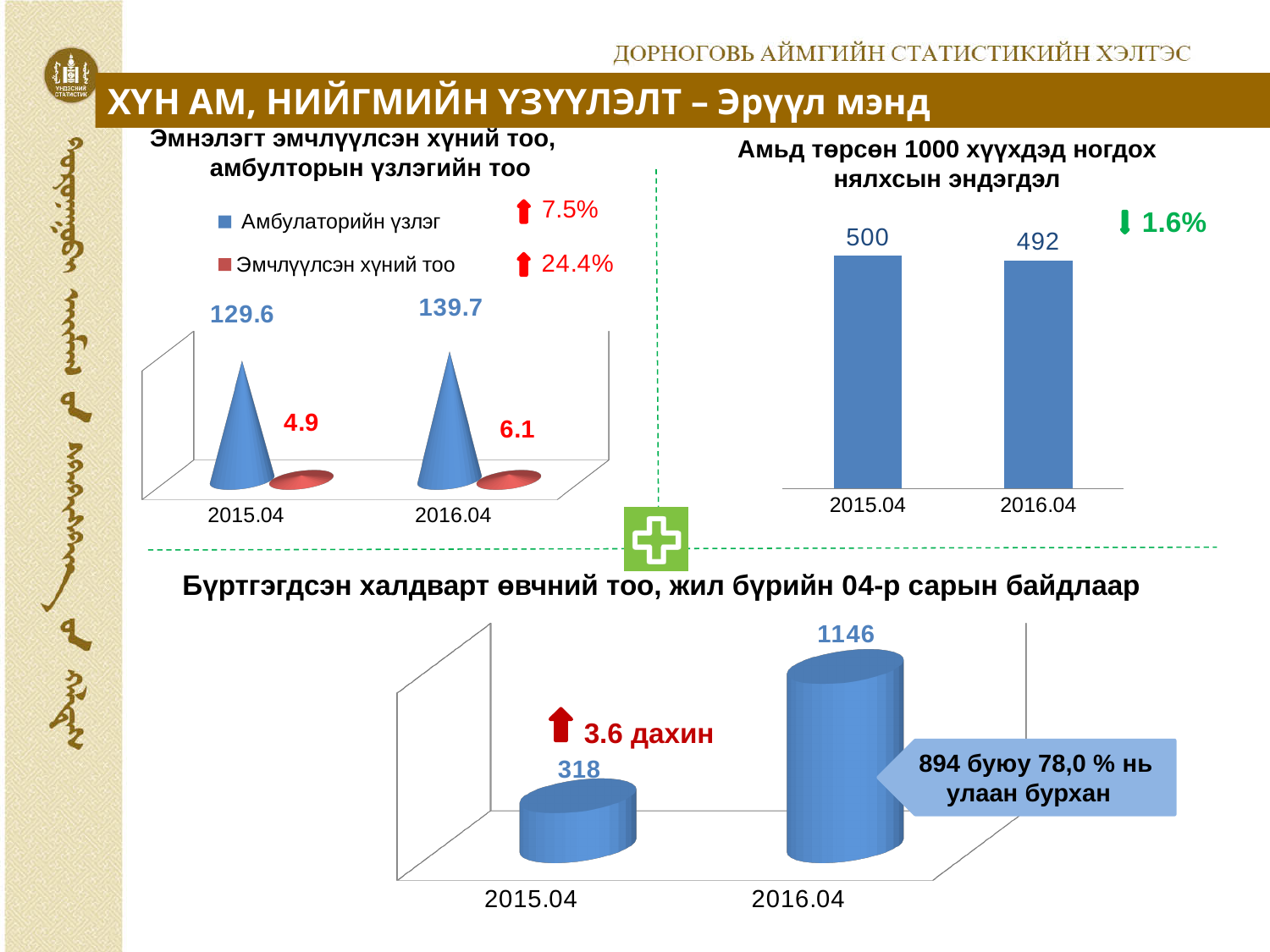
In the top-right chart (Амьд төрсөн 1000 хүүхдэд ногдох нялхсын эндэгдэл), what is the value for 2015.04? 500 In the top-left chart, what is the difference between the Амбулаторийн үзлэг values for 2016.04 and 2015.04? 10.1 In the top-right chart, which year has the lower value? 2016.04 What kind of chart is the top-right chart? bar chart In the bottom chart, how many categories are shown on the x axis? 2 In the top-left chart, does the Эмчлүүлсэн хүний тоо series rise or fall from 2015.04 to 2016.04? rise In the bottom chart, what is the difference between the 2016.04 and 2015.04 values? 828 In the top-left chart, how many series does the legend list? 2 In the top-left chart (Эмнэлэгт эмчлүүлсэн хүний тоо, амбулторын үзлэгийн тоо), what is the value of Амбулаторийн үзлэг for 2016.04? 139.7 In the top-right chart, what is the difference between the 2015.04 and 2016.04 values? 8 In the top-left chart, what is the value of Эмчлүүлсэн хүний тоо for 2015.04? 4.9 In the bottom chart (Бүртгэгдсэн халдварт өвчний тоо), what is the value for 2016.04? 1146